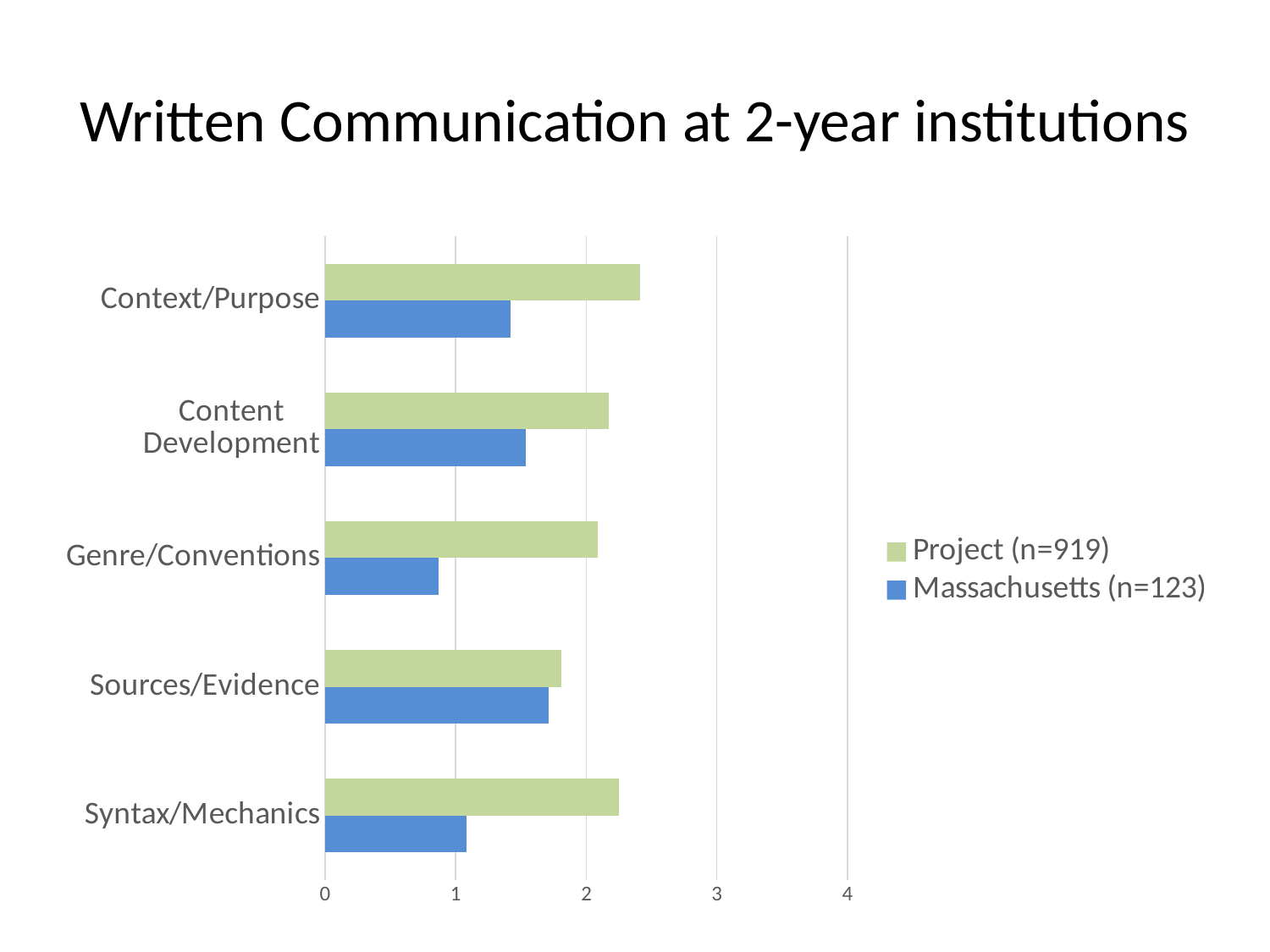
Is the Project (n=919) value for Sources/Evidence greater or less than 2? less Which category has the highest value for the Massachusetts (n=123) series? Sources/Evidence Which category has the lowest value for the Project (n=919) series? Sources/Evidence How many series does the legend list? 2 What is the title of the chart? Written Communication at 2-year institutions Is the Massachusetts (n=123) value for Genre/Conventions greater or less than 1? less Which category has the lowest value for the Massachusetts (n=123) series? Genre/Conventions Which category has the highest value for the Project (n=919) series? Context/Purpose For Genre/Conventions, which series has the larger value, Project (n=919) or Massachusetts (n=123)? Project (n=919) What kind of chart is shown on the slide? bar chart Is the Project (n=919) value for Context/Purpose greater or less than 2? greater How many categories are shown on the chart? 5